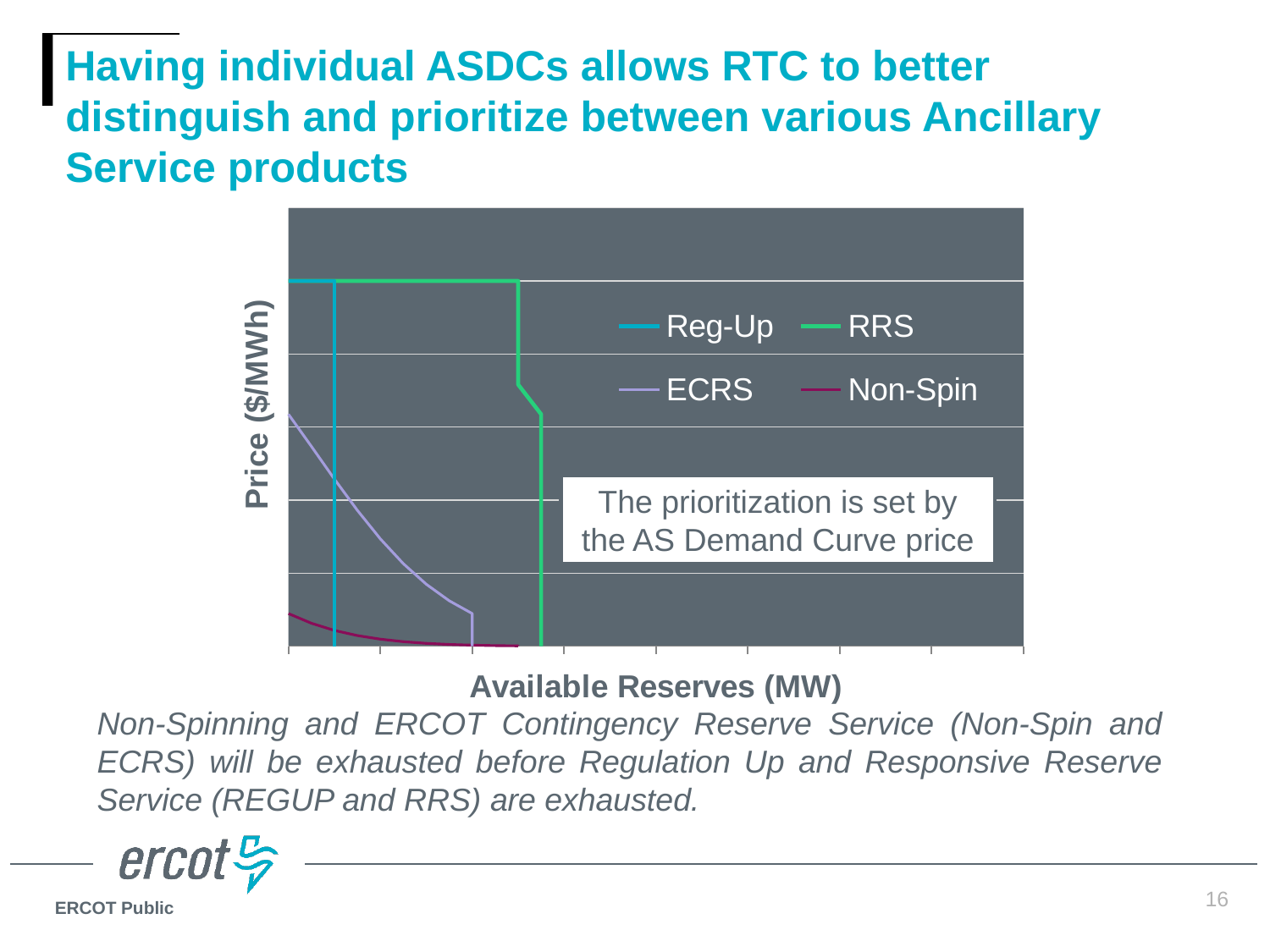
Does the Non-Spin price rise or fall as Available Reserves increase? fall Which series extends furthest to the right along the Available Reserves axis before dropping to zero? RRS Does the ECRS price rise or fall as Available Reserves increase? fall What is the label of the chart's horizontal axis? Available Reserves (MW) Which series has the higher price at the left edge of the chart, Reg-Up or ECRS? Reg-Up What are the four series named in the chart's legend? Reg-Up, RRS, ECRS, Non-Spin What kind of chart is shown on the slide? line chart What is the label of the chart's vertical axis? Price ($/MWh) How many series does the chart's legend list? 4 Which series has the higher price at the left edge of the chart, ECRS or Non-Spin? ECRS Which series drops to zero at the smallest amount of Available Reserves? Reg-Up Which series has the lowest price across the chart? Non-Spin